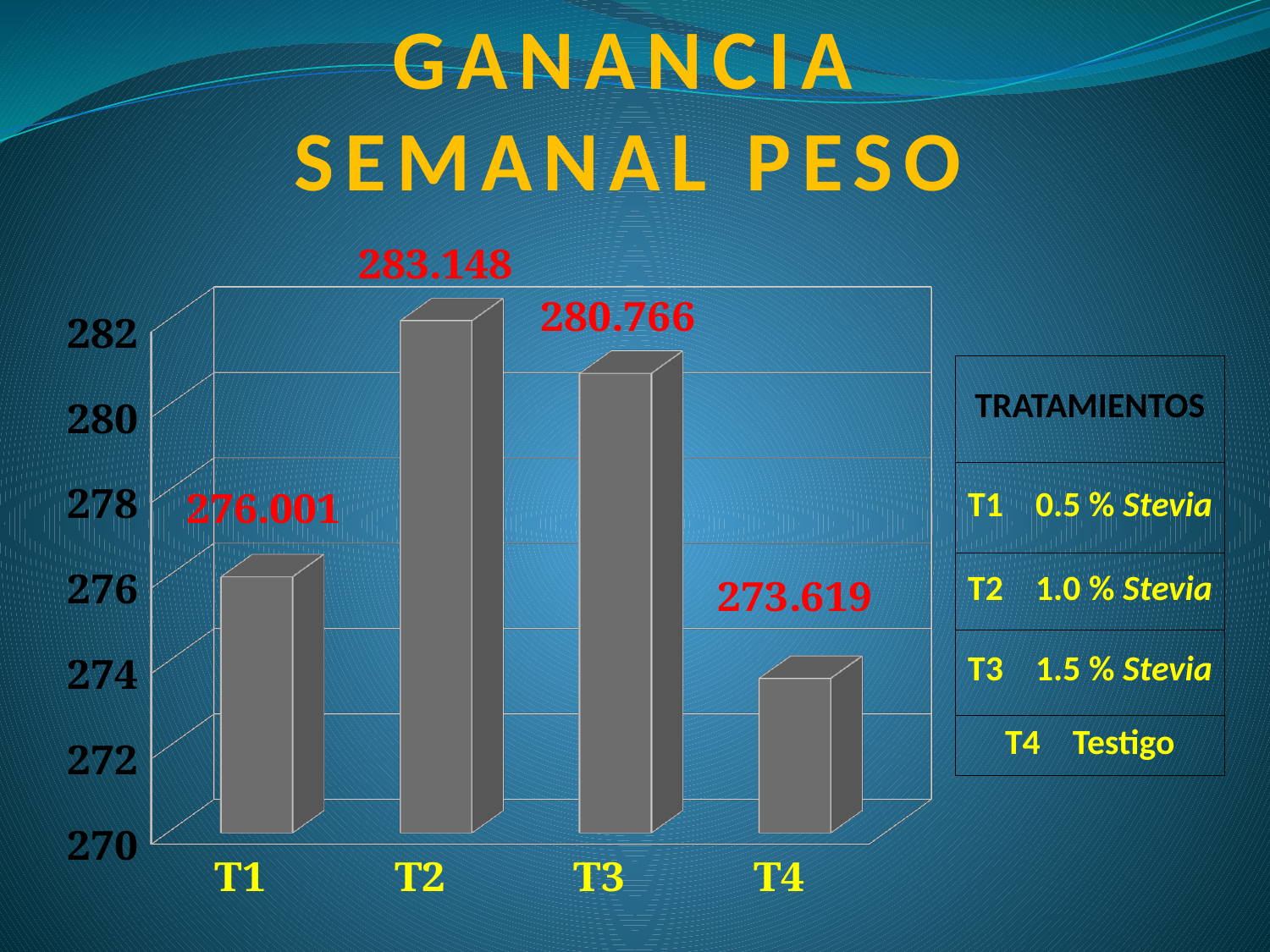
Which category has the lowest value? T4 Is the value for T4 greater or less than 274? less What is the difference between the values for T2 and T4? 9.529 What is the value for T4? 273.619 What is the value for T2? 283.148 Which category has the highest value? T2 What kind of chart is shown on the slide? bar chart What is the difference between the values for T3 and T1? 4.765 According to the table on the slide, what treatment does T4 correspond to? Testigo Which is larger, the value for T1 or the value for T3? T3 What is the value for T1? 276.001 How many categories are shown on the x axis? 4